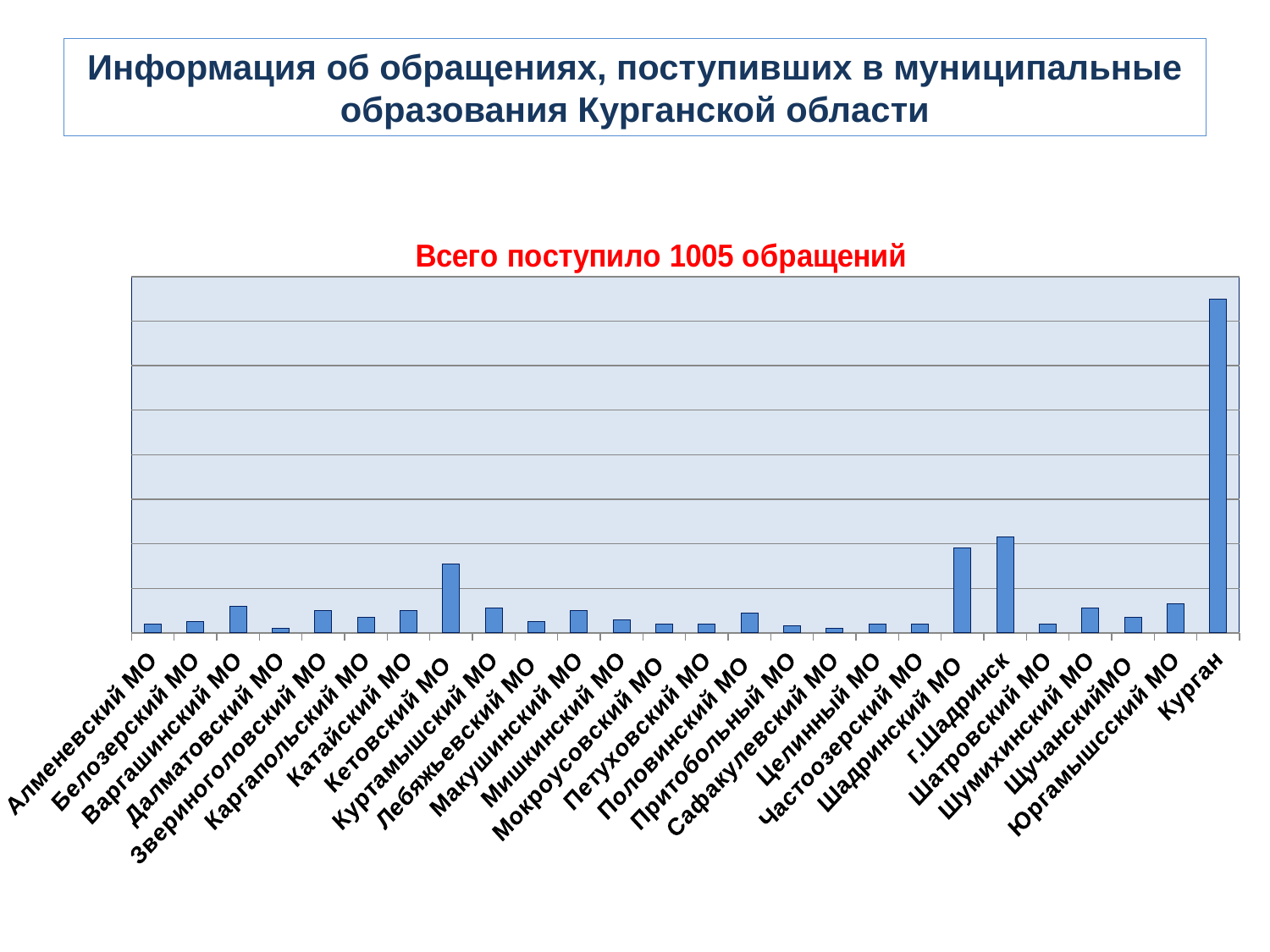
According to the chart heading, how many appeals were received in total? 1005 Which has the larger value, Кетовский МО or Шадринский МО? Шадринский МО Which has the larger value, Кетовский МО or Куртамышский МО? Кетовский МО Which has the larger value, Варгашинский МО or Далматовский МО? Варгашинский МО Which municipality has the second highest bar in the chart? г.Шадринск What kind of chart is shown on the slide? bar chart How many municipalities (categories) are shown on the x axis of the chart? 26 Which municipality has the highest bar in the chart? Курган What is the title of the slide? Информация об обращениях, поступивших в муниципальные образования Курганской области